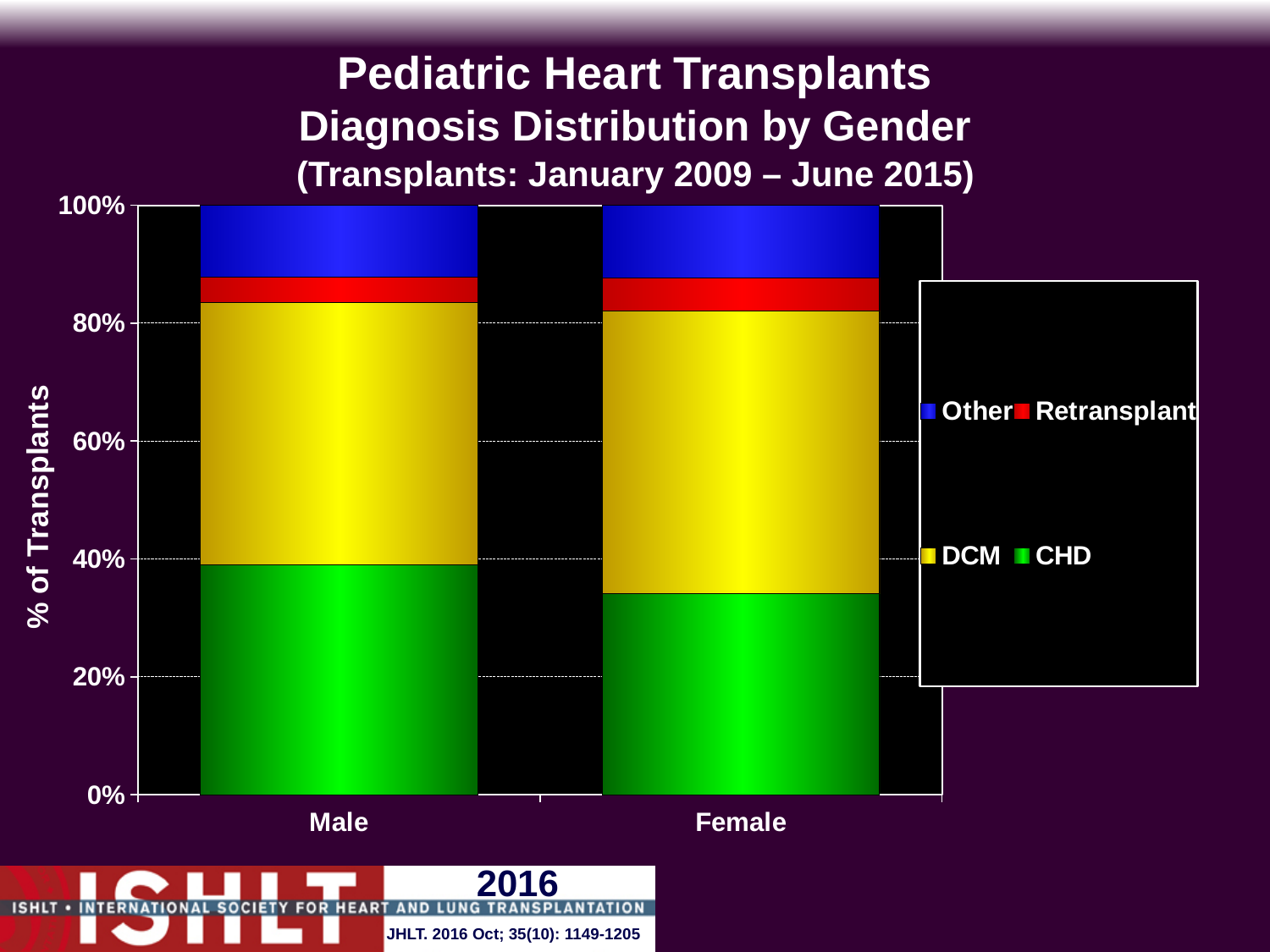
Is the CHD share for Female greater or less than 40%? less Which gender has the larger DCM share, Male or Female? Female How many series does the legend list? 4 What is the total height of the stacked bar for Male? 100% What kind of chart is shown on the slide? Stacked bar chart Which series forms the smallest segment in the Male bar? Retransplant Is the CHD share for Male greater or less than 20%? greater Which gender has the larger CHD share, Male or Female? Male Which series is shown in green in the legend? CHD How many categories are shown on the x axis? 2 Is the top of the DCM segment for Male greater or less than 60%? greater What is the label of the y axis? % of Transplants